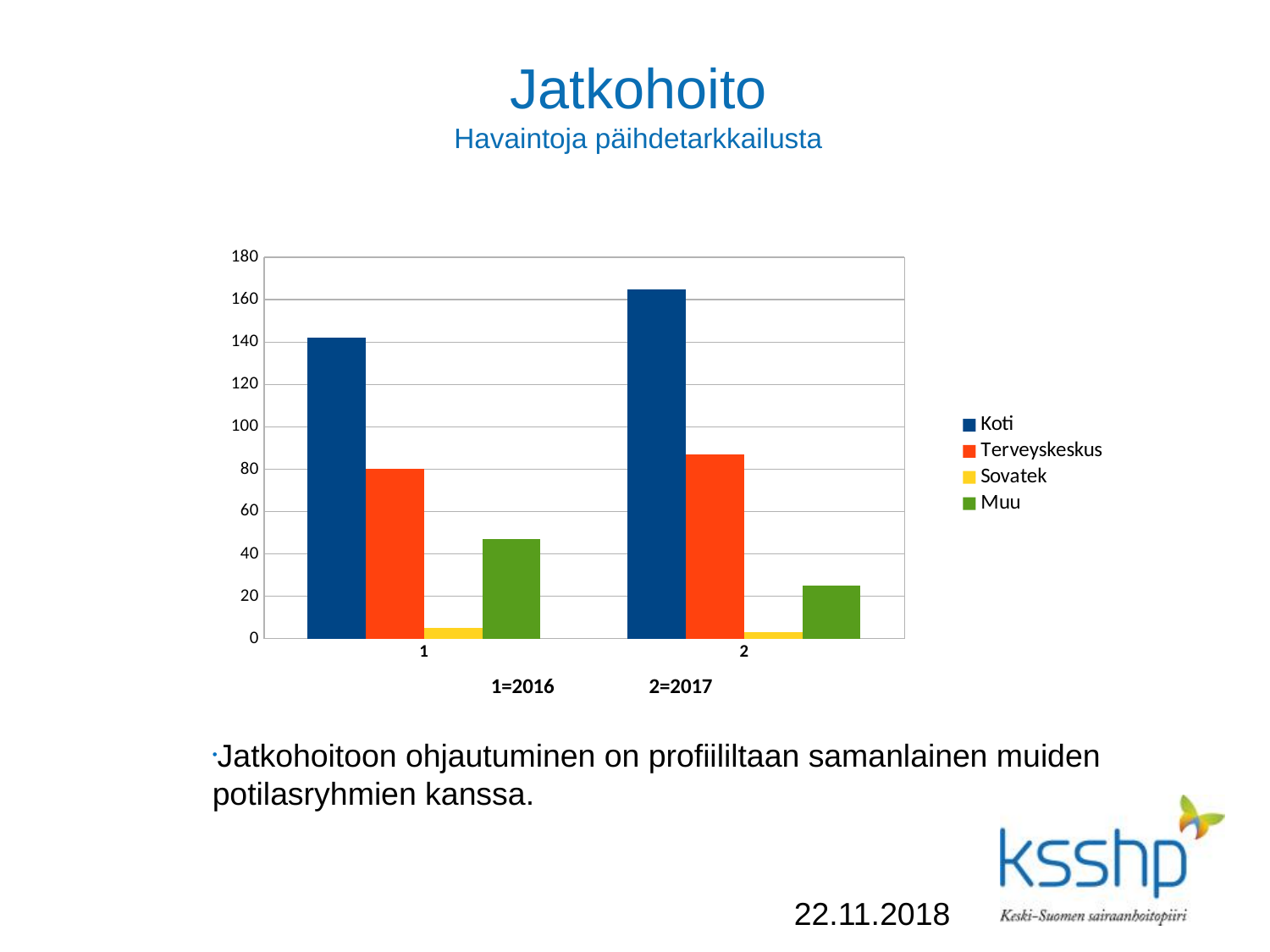
How many series does the legend list? 4 Which series has the highest value in category 2? Koti According to the note under the x axis, which year does category 2 represent? 2017 Is the value for Koti in category 2 greater or less than 160? greater Which series is shown in green in the legend? Muu Which series has the lowest value in category 1? Sovatek What kind of chart is shown on the slide? bar chart Is the value for Koti in category 1 greater or less than 120? greater Is the value for Muu in category 2 greater or less than 40? less How many categories are shown on the x axis? 2 Does the value for Koti rise or fall from category 1 to category 2? rise Which is larger, Muu in category 1 or Muu in category 2? Muu in category 1